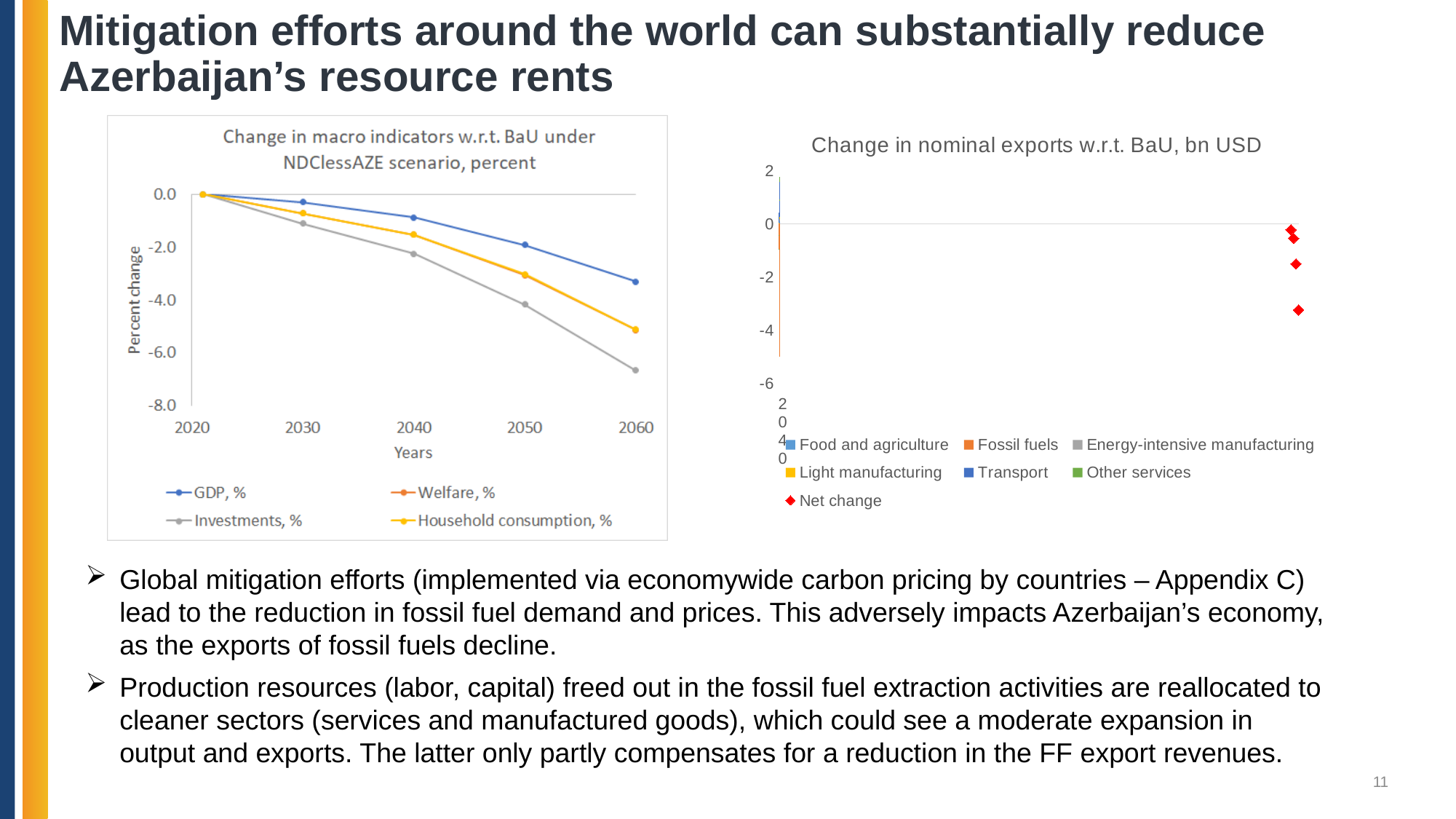
In the left chart (Change in macro indicators), which is larger in 2040: Household consumption, % or Investments, %? Household consumption, % In the left chart (Change in macro indicators), is the value for GDP, % in 2060 greater or less than -4.0? greater In the left chart (Change in macro indicators), which series has the lowest value in 2060? Investments, % In the left chart (Change in macro indicators), do the series rise or fall from 2020 to 2060? Fall What kind of chart is the left chart titled 'Change in macro indicators w.r.t. BaU under NDClessAZE scenario, percent'? Line chart In the left chart (Change in macro indicators), which series has the highest value in 2060? GDP, % In the left chart (Change in macro indicators), how many series does the legend list? 4 In the left chart (Change in macro indicators), how many years are plotted along the x axis? 5 In the right chart titled 'Change in nominal exports w.r.t. BaU, bn USD', how many entries does the legend list? 7 In the left chart (Change in macro indicators), is the value for Investments, % in 2060 greater or less than -6.0? less In the left chart (Change in macro indicators), is the value for Household consumption, % in 2050 greater or less than -2.0? less In the left chart (Change in macro indicators), what is the value of GDP, % in 2020? 0.0